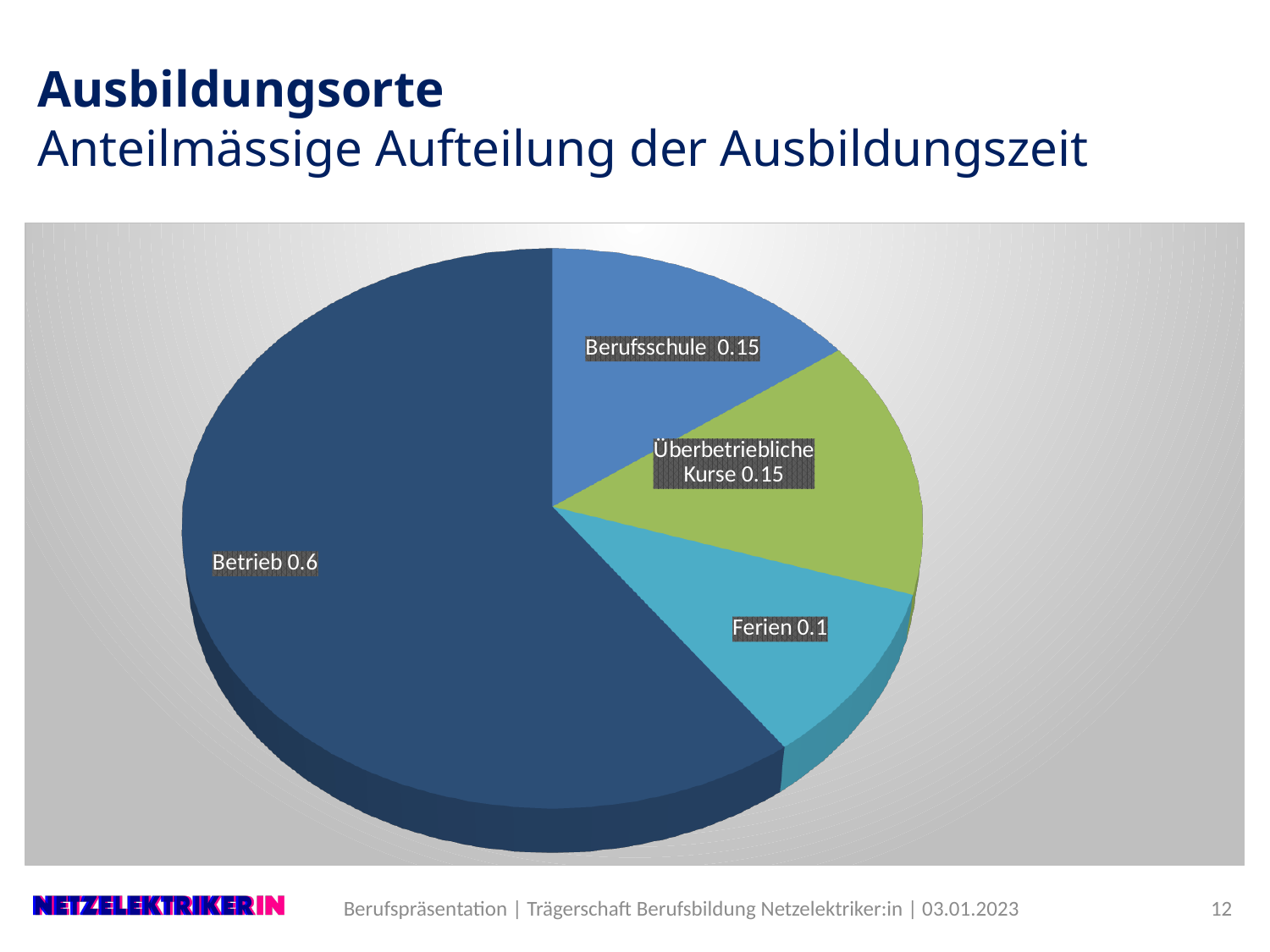
What is the value shown for Berufsschule? 0.15 Which category has the largest slice of the pie? Betrieb Which category has the smallest slice of the pie? Ferien How many slices does the pie chart have? 4 What colour is the Betrieb slice? Dark blue What is the difference between the values for Betrieb and Ferien? 0.5 What kind of chart is shown on the slide? Pie chart What is the value shown for Überbetriebliche Kurse? 0.15 Which is larger, the value for Berufsschule or the value for Ferien? Berufsschule What is the value shown for Betrieb? 0.6 What is the difference between the values for Berufsschule and Ferien? 0.05 What is the value shown for Ferien? 0.1